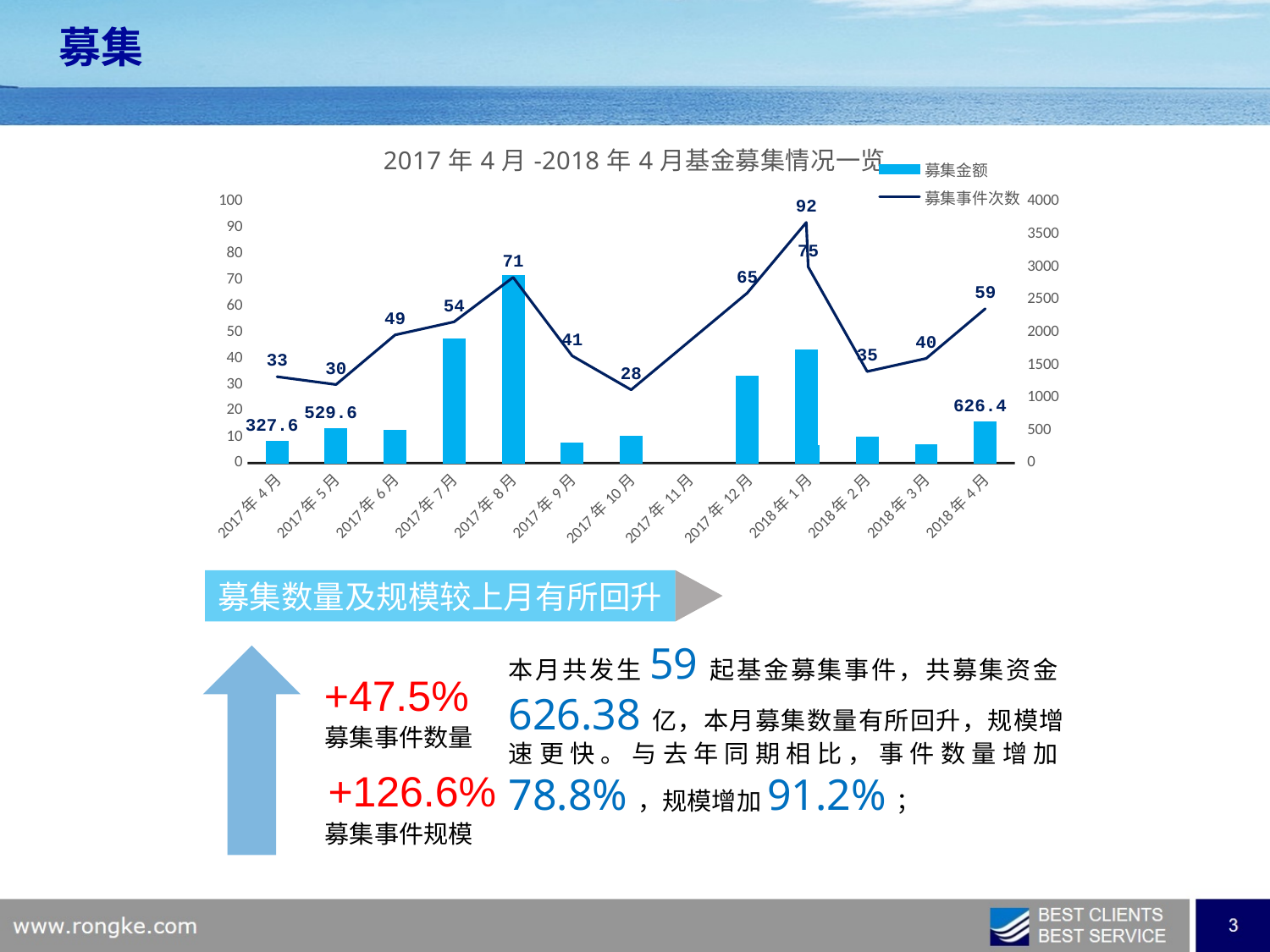
What is the difference in 募集事件次数 between 2017年8月 and 2017年4月? 38 What is the 募集金额 value for 2018年4月? 626.4 How many series does the legend list? 2 Is the 募集金额 value for 2017年8月 greater or less than 2500? greater What is the difference in 募集金额 between 2018年4月 and 2017年4月? 298.8 How many months are shown on the x axis? 13 Which has the larger 募集事件次数, 2017年6月 or 2018年2月? 2017年6月 What kind of chart is shown on the slide? Combined bar and line chart Which month has the lowest 募集事件次数? 2017年10月 What is the 募集事件次数 value for 2017年8月? 71 What is the title of the chart? 2017年4月-2018年4月基金募集情况一览